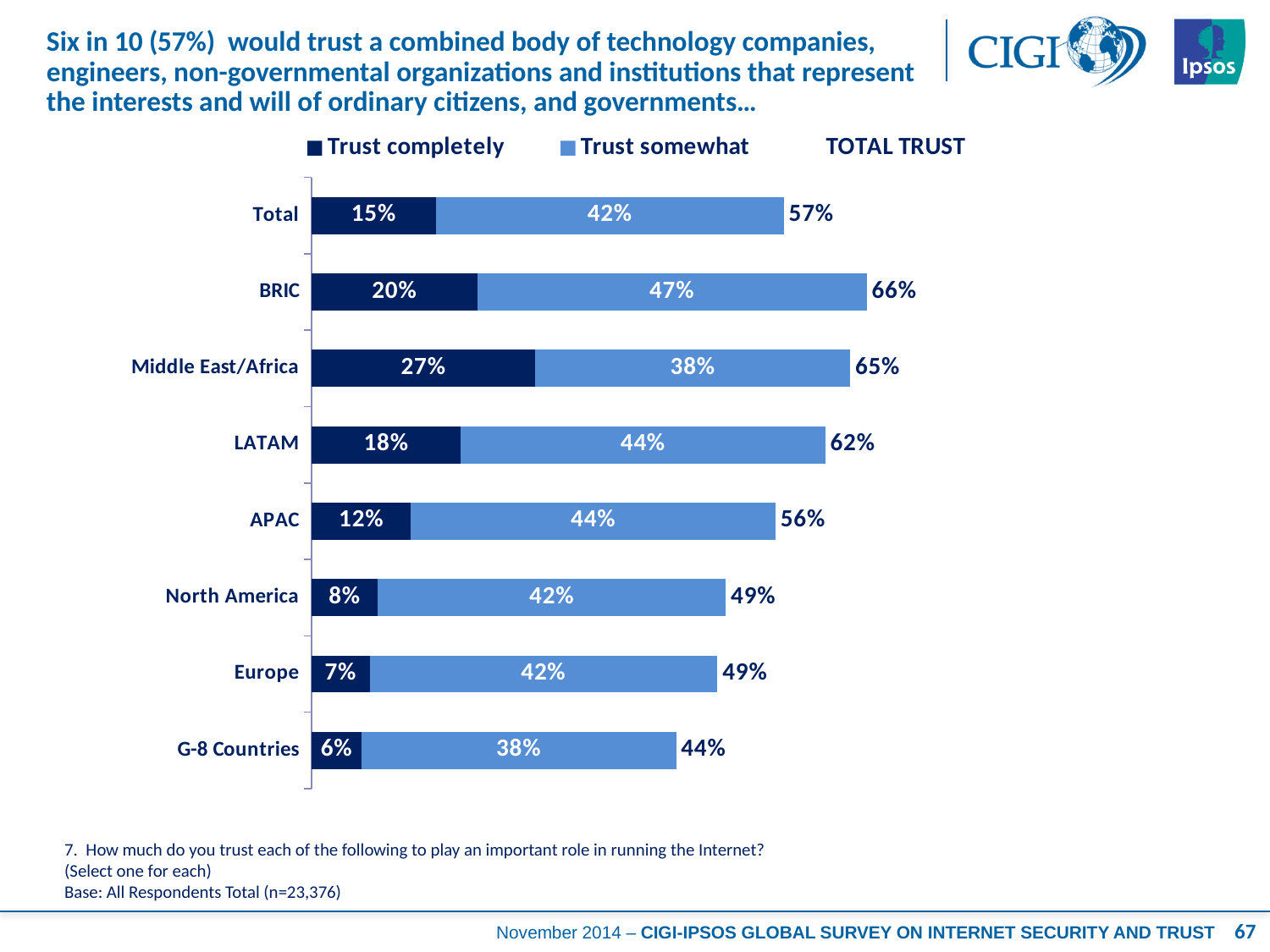
Which is larger, the 'Trust somewhat' value for LATAM or for Middle East/Africa? LATAM Which legend entry is shown in the darker navy colour? Trust completely What is the 'Trust completely' value for Middle East/Africa? 27% What is the total of the stacked bar for Europe, as shown by the TOTAL TRUST label? 49% How many series does the legend list? 3 How many regions/categories are plotted in the chart? 8 What is the TOTAL TRUST value for LATAM? 62% What is the 'Trust somewhat' value for BRIC? 47% What kind of chart is shown on the slide? Stacked bar chart What is the difference between the 'Trust completely' values for BRIC and APAC? 8% Which category has the highest 'Trust completely' value? Middle East/Africa Which category has the lowest TOTAL TRUST value? G-8 Countries